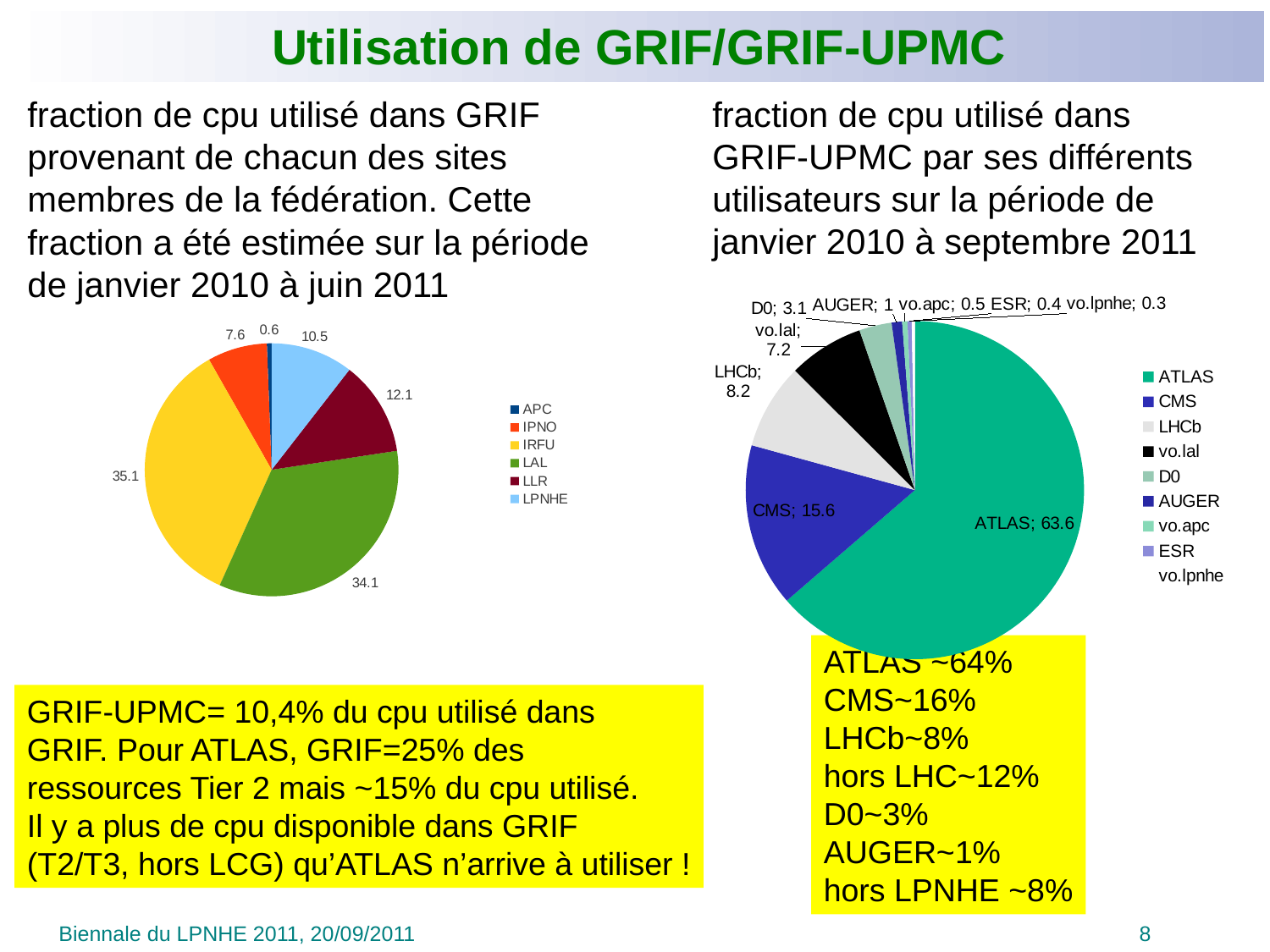
What type of chart is shown on the right side of the slide? Pie chart In the right pie chart, which user has the largest slice? ATLAS In the left pie chart, which site has the smallest slice? APC In the left pie chart, what is the value for IRFU? 35.1 In the left pie chart, what is the value for LPNHE? 10.5 In the right pie chart, which is larger, the value for CMS or the value for LHCb? CMS How many categories does the legend of the left pie chart list? 6 In the right pie chart, what is the difference between the values for ATLAS and CMS? 48.0 In the right pie chart, what is the value for ATLAS? 63.6 In the right pie chart, what is the value for vo.lal? 7.2 In the left pie chart, which site has the largest slice? IRFU In the left pie chart, what is the difference between the values for LLR and IPNO? 4.5